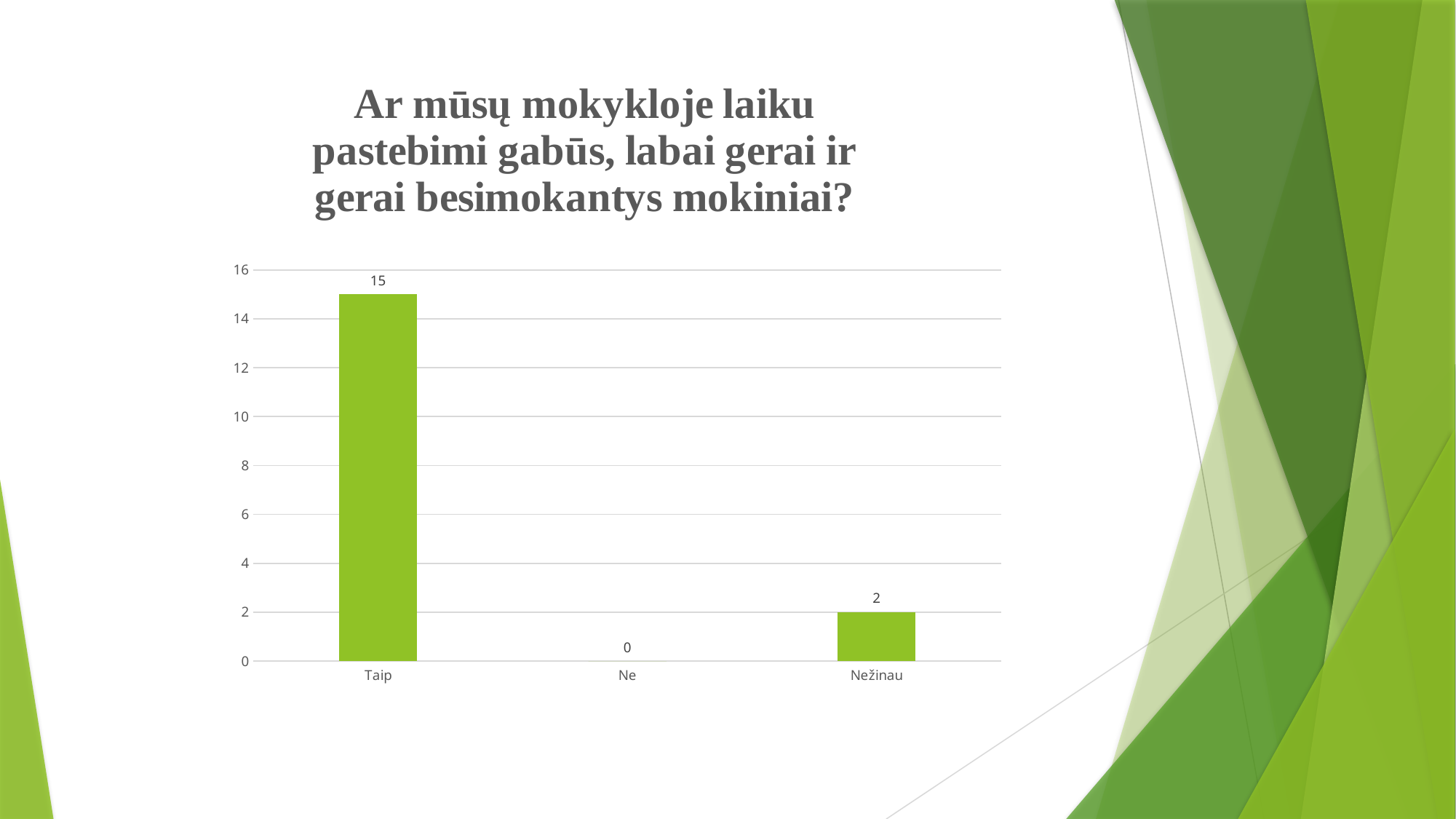
What is the value for Taip? 15 What is the value for Nežinau? 2 What is the difference between the values for Taip and Nežinau? 13 What is the maximum value shown on the y axis? 16 How many categories are shown on the x axis? 3 Which category has the highest value? Taip What is the total of all three values shown in the chart? 17 Which is larger, the value for Nežinau or the value for Ne? Nežinau Is the value for Taip greater or less than 10? greater What kind of chart is shown on the slide? bar chart Which category has the lowest value? Ne What is the value for Ne? 0